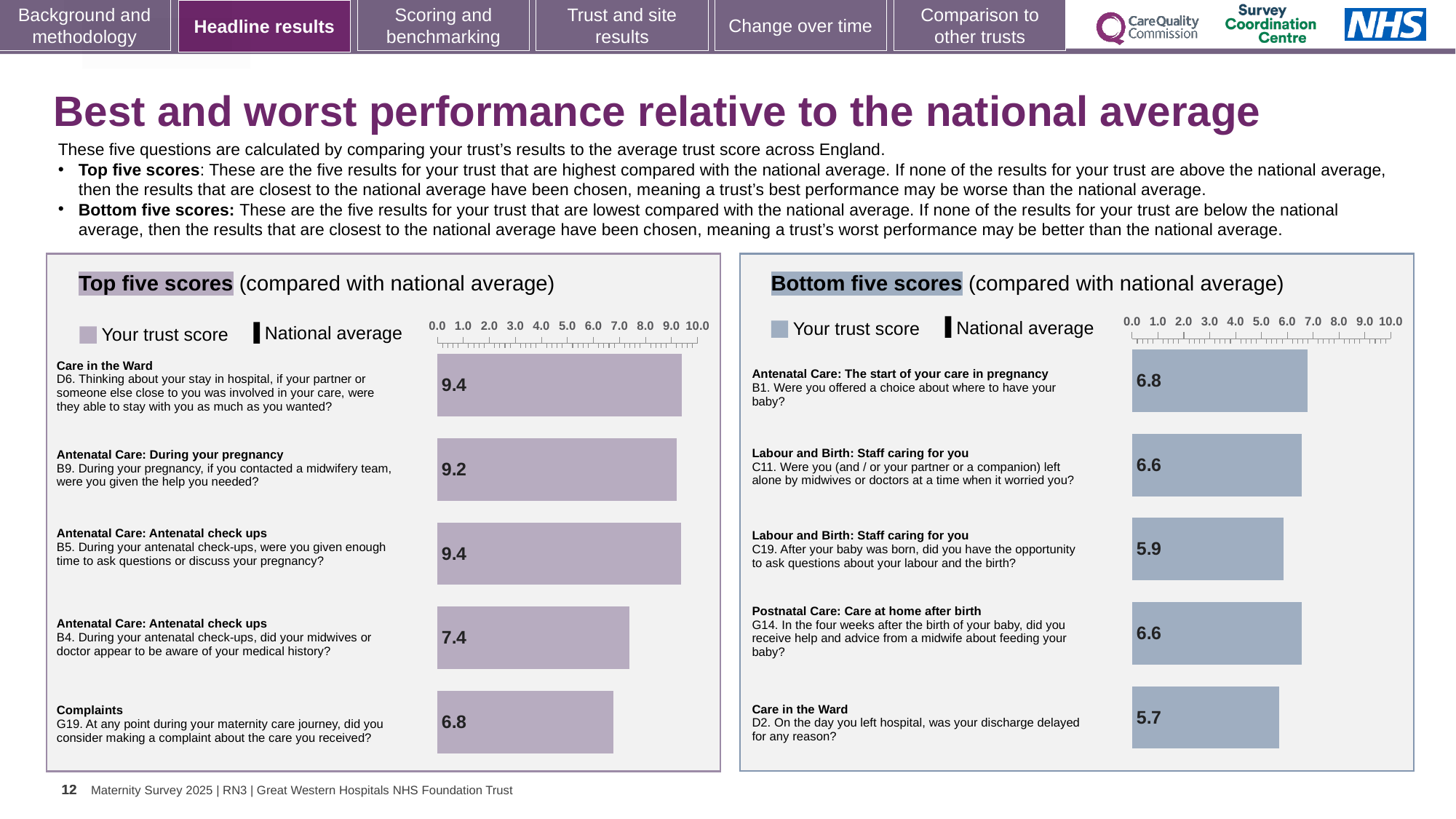
In the Bottom five scores chart, what is the difference between the trust score for B1 and the trust score for D2? 1.1 In the Bottom five scores chart, which question has the lowest trust score? D2 (Care in the Ward) How many questions are shown in the Bottom five scores chart? 5 In the Bottom five scores chart, what is the trust score for question C19 about having the opportunity to ask questions about your labour and the birth? 5.9 In the Top five scores chart, which question has the lowest trust score? G19 (Complaints) In the Top five scores chart, what is the difference between the trust score for D6 and the trust score for G19? 2.6 In the Top five scores chart, what is the trust score for question B9 about contacting a midwifery team during pregnancy? 9.2 In the Bottom five scores chart, which question has the highest trust score? B1 (Antenatal Care: The start of your care in pregnancy) In the Bottom five scores chart, what is the trust score for question B1 about being offered a choice about where to have your baby? 6.8 In the Top five scores chart, which has the larger trust score: B9 or B4? B9 What type of chart is used in the Top five scores panel? Bar chart In the Top five scores chart, what is the trust score for question B4 about midwives or doctors being aware of your medical history? 7.4